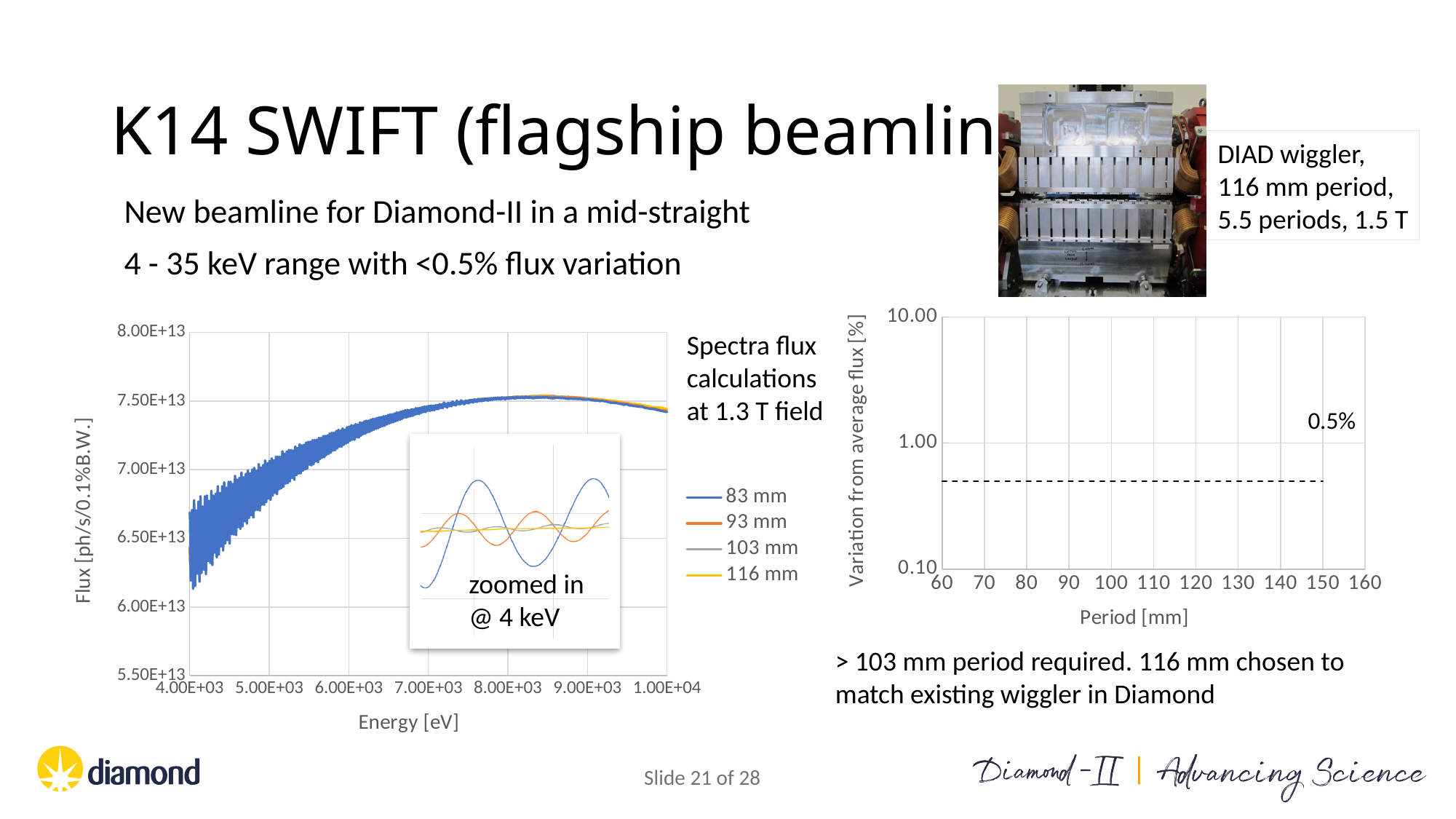
What is the x-axis label of the left flux chart? Energy [eV] What kind of chart is the left chart showing flux against energy? line chart In the left flux chart, is the flux of the 83 mm series at 4.00E+03 eV greater or less than 7.00E+13? less What is the x-axis label of the right chart? Period [mm] In the left flux chart, is the flux at 6.00E+03 eV greater or less than 7.00E+13? greater In the zoomed-in inset of the left flux chart, which series shows the largest oscillation at 4 keV? 83 mm In the left flux chart, which series is drawn in blue? 83 mm In the right chart, is the dashed line greater or less than 1.00 on the variation axis? less How many tick labels are shown on the x-axis of the right chart? 11 What value is labelled on the dashed line in the right chart of variation from average flux? 0.5% In the left flux chart, does the flux rise or fall as energy increases from 4.00E+03 to 7.00E+03 eV? rise How many series does the legend of the left flux chart list? 4